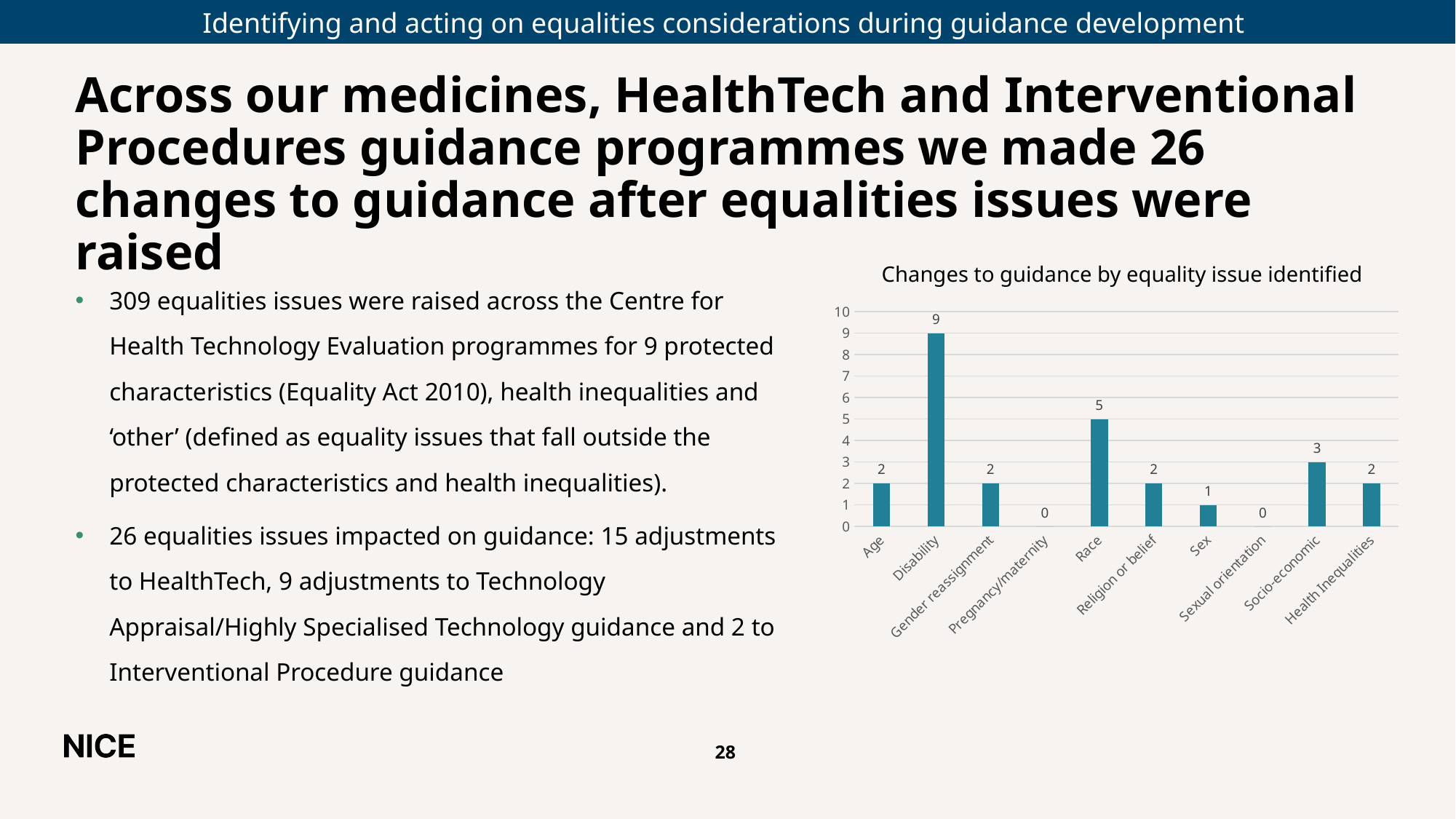
Which categories have a value of 0 in the chart? Pregnancy/maternity and Sexual orientation What is the total of the values for Age, Gender reassignment and Religion or belief? 6 What is the value for Race in the chart? 5 What is the difference between the values for Disability and Race? 4 Which is larger, the value for Socio-economic or the value for Health Inequalities? Socio-economic What is the value for Socio-economic in the chart? 3 What is the title of the chart? Changes to guidance by equality issue identified What kind of chart is shown on the slide? Bar chart What is the value for Disability in the chart? 9 How many categories are shown on the x axis of the chart? 10 What is the value for Sex in the chart? 1 Which category has the highest value in the chart? Disability